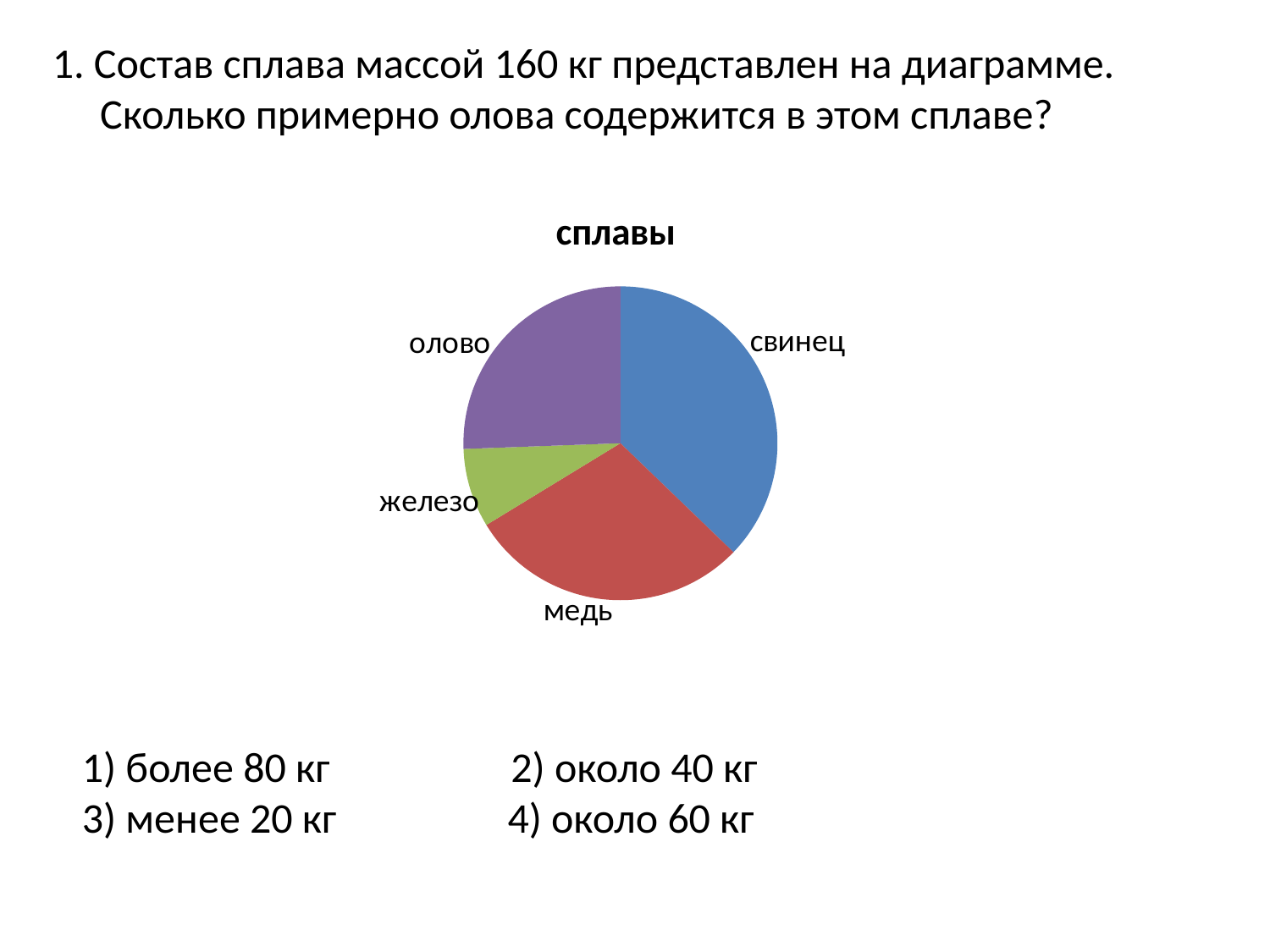
How many slices does the pie chart have? 4 What is the title of the pie chart? сплавы Which slice is larger, олово or железо? олово What kind of chart is shown on the slide? pie chart What colour is the slice for железо? green Which component has the largest slice in the pie chart? свинец Which slice is larger, свинец or медь? свинец Which slice is larger, свинец or олово? свинец Which component has the smallest slice in the pie chart? железо